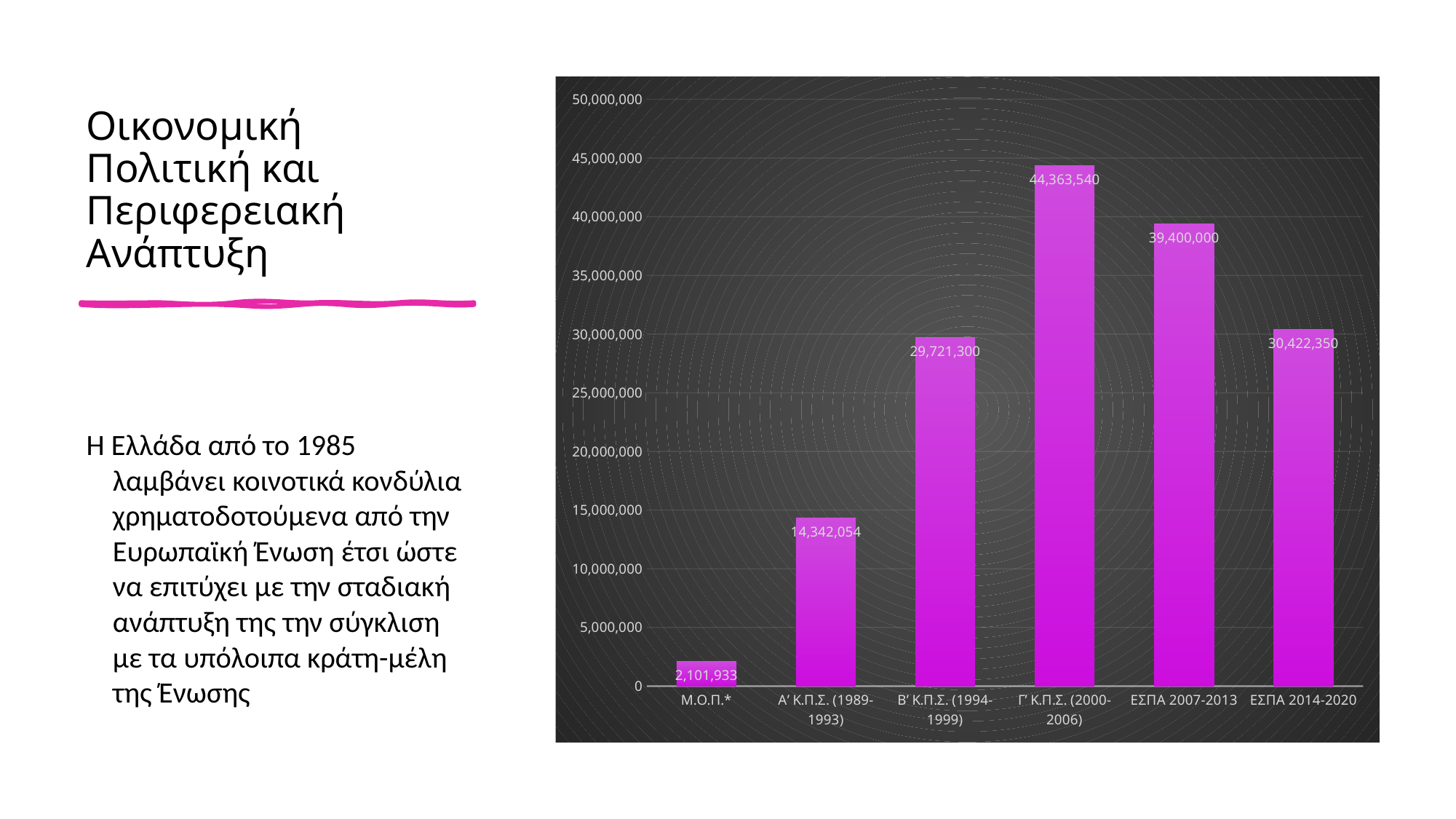
What is the value for Γ' Κ.Π.Σ. (2000-2006)? 44,363,540 How many categories are shown on the x axis? 6 Which category has the highest value? Γ' Κ.Π.Σ. (2000-2006) What is the value for Μ.Ο.Π.*? 2,101,933 Which is larger, the value for ΕΣΠΑ 2007-2013 or the value for ΕΣΠΑ 2014-2020? ΕΣΠΑ 2007-2013 What is the value for Α' Κ.Π.Σ. (1989-1993)? 14,342,054 What is the difference between the values for ΕΣΠΑ 2014-2020 and Β' Κ.Π.Σ. (1994-1999)? 701,050 Which category has the lowest value? Μ.Ο.Π.* What is the value for ΕΣΠΑ 2007-2013? 39,400,000 Is the value for Β' Κ.Π.Σ. (1994-1999) greater or less than 30,000,000? less What is the difference between the values for Γ' Κ.Π.Σ. (2000-2006) and ΕΣΠΑ 2007-2013? 4,963,540 What kind of chart is shown on the slide? bar chart